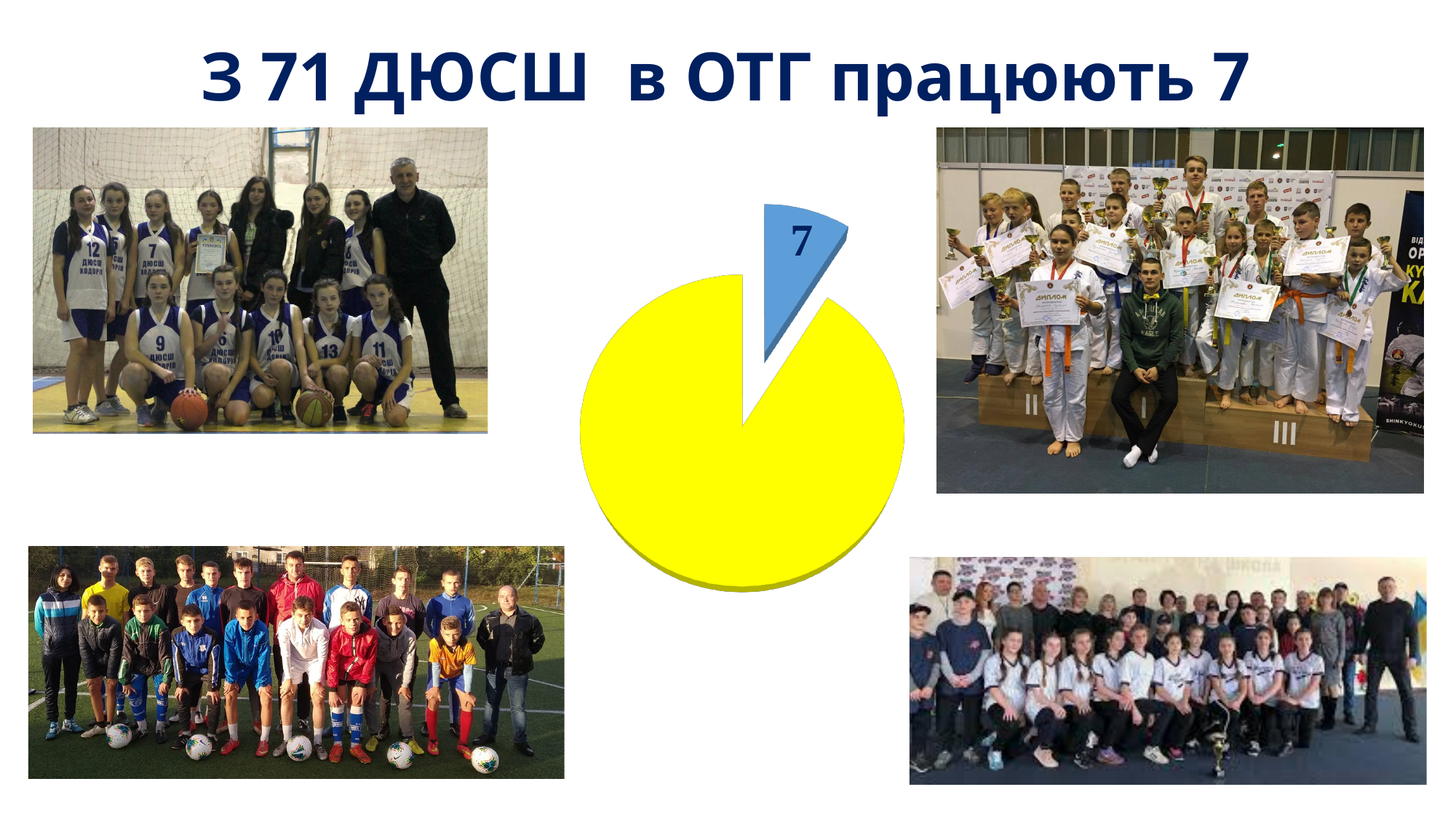
Which colour slice is the smallest in the pie chart? blue Which slice of the pie chart is larger, the yellow one or the blue one? the yellow one Which colour slice is the largest in the pie chart? yellow What kind of chart is shown in the centre of the slide? pie chart How many slices does the pie chart have? 2 What is the title text at the top of the slide? З 71 ДЮСШ в ОТГ працюють 7 What colour is the pie slice that carries the data label 7? blue What value is printed on the small blue slice of the pie chart? 7